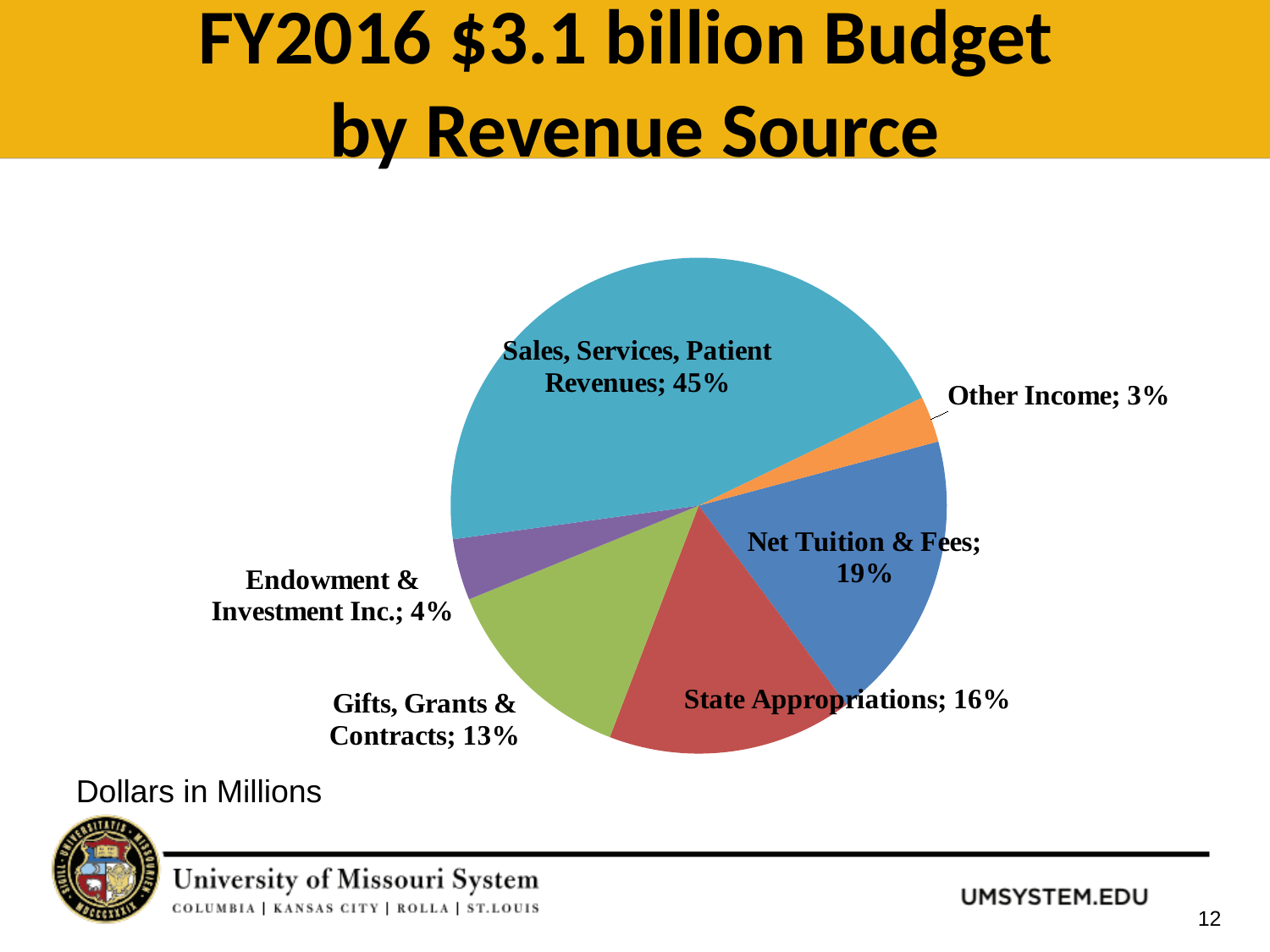
How many revenue sources are shown in the pie chart? 6 What share of the FY2016 budget comes from Sales, Services, Patient Revenues? 45% How many percentage points larger is Net Tuition & Fees than State Appropriations? 3 What is the title of the slide containing the pie chart? FY2016 $3.1 billion Budget by Revenue Source What share of the budget comes from Gifts, Grants & Contracts? 13% What share of the budget comes from Net Tuition & Fees? 19% Which is larger: Gifts, Grants & Contracts or Endowment & Investment Inc.? Gifts, Grants & Contracts What percentage of the budget is Endowment & Investment Inc.? 4% What kind of chart is shown on the slide? pie chart What percentage of the budget is State Appropriations? 16% Which revenue source is the smallest slice of the pie? Other Income Which revenue source is the largest slice of the pie? Sales, Services, Patient Revenues